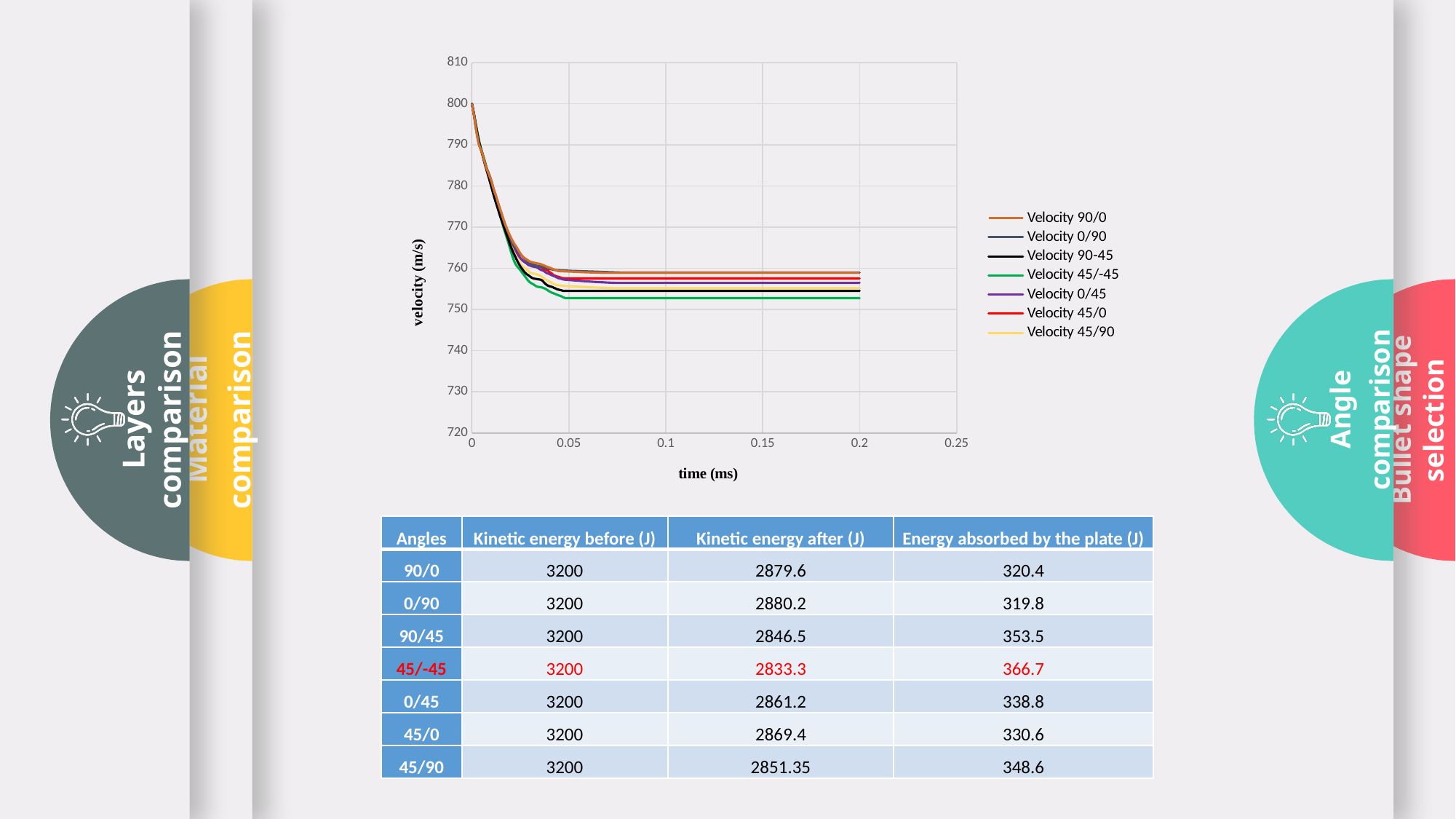
At 0.2 ms, which series has the higher velocity: Velocity 90/0 or Velocity 45/-45? Velocity 90/0 What is the label of the x axis of the chart? time (ms) Which series ends at the lowest velocity at 0.2 ms? Velocity 45/-45 What is the label of the y axis of the chart? velocity (m/s) Is the final velocity of the Velocity 45/-45 series greater or less than 760? less What kind of chart is shown on the slide? line chart Is the final velocity of the Velocity 90/0 series greater or less than 750? greater At 0.2 ms, which series has the higher velocity: Velocity 0/45 or Velocity 45/-45? Velocity 0/45 Is the starting velocity of the series at time 0 greater or less than 790? greater How many series does the legend of the velocity chart list? 7 Do the velocity values rise or fall as time increases along the x axis? fall